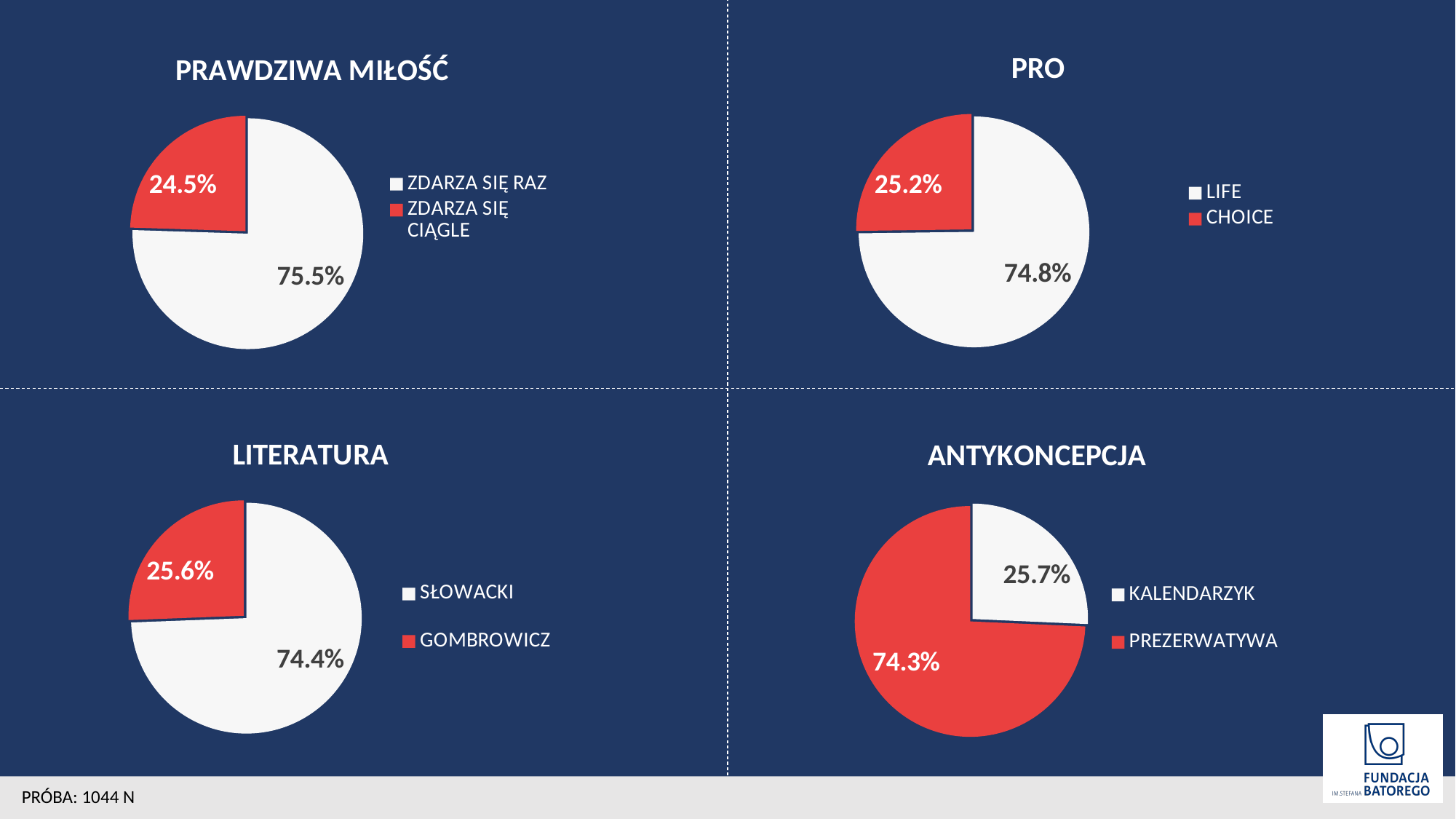
In the PRAWDZIWA MIŁOŚĆ chart, what colour is the ZDARZA SIĘ CIĄGLE slice? red In the ANTYKONCEPCJA chart, which category has the smaller slice? KALENDARZYK In the PRAWDZIWA MIŁOŚĆ chart, what share is labelled for ZDARZA SIĘ CIĄGLE? 24.5% In the ANTYKONCEPCJA chart, what share is labelled for PREZERWATYWA? 74.3% In the ANTYKONCEPCJA chart, is the share for KALENDARZYK larger or smaller than the share for PREZERWATYWA? smaller How many slices does the LITERATURA chart have? 2 In the PRO chart, which category has the larger slice? LIFE In the PRO chart, what share is labelled for CHOICE? 25.2% In the LITERATURA chart, what is the difference between the SŁOWACKI and GOMBROWICZ shares? 48.8% What kind of chart is the PRO chart? pie chart In the PRAWDZIWA MIŁOŚĆ chart, what share is labelled for ZDARZA SIĘ RAZ? 75.5% In the LITERATURA chart, what share is labelled for GOMBROWICZ? 25.6%